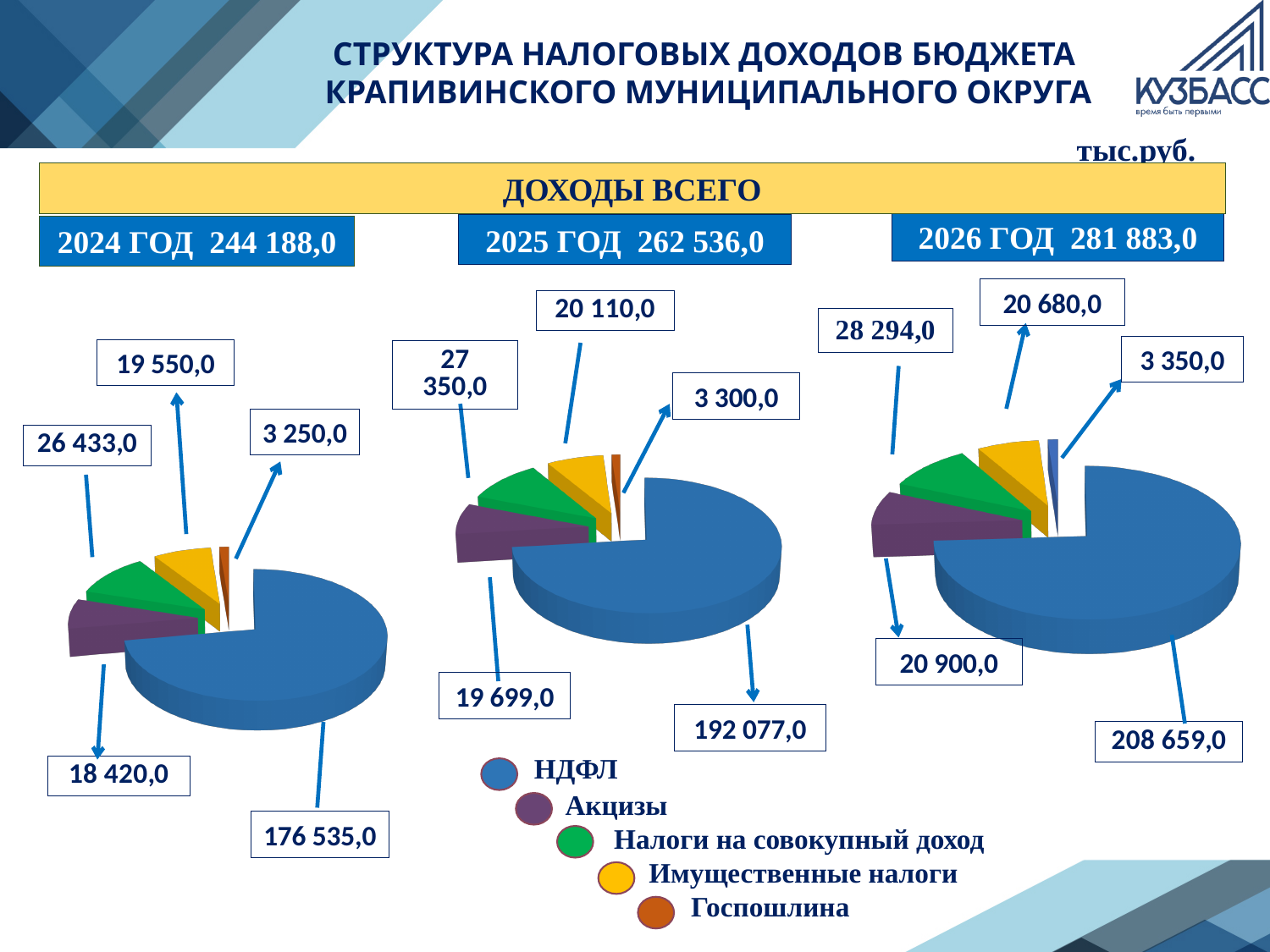
In the 2025 pie chart, what is the difference between Налоги на совокупный доход and Имущественные налоги? 7 240,0 In the 2025 pie chart, what is the value for Акцизы? 19 699,0 How many categories does the legend list? 5 How many slices does the 2025 pie chart have? 5 What is the total of all slices in the 2026 pie chart? 281 883,0 In the 2024 pie chart, which category has the smallest slice? Госпошлина In the 2024 pie chart, what is the value for НДФЛ? 176 535,0 Which legend entry is shown in green? Налоги на совокупный доход In the 2026 pie chart, which category has the largest slice? НДФЛ What type of chart is used for each year on the slide? Pie chart In the 2024 pie chart, which is larger: Акцизы or Имущественные налоги? Имущественные налоги In the 2026 pie chart, what is the value for Налоги на совокупный доход? 28 294,0